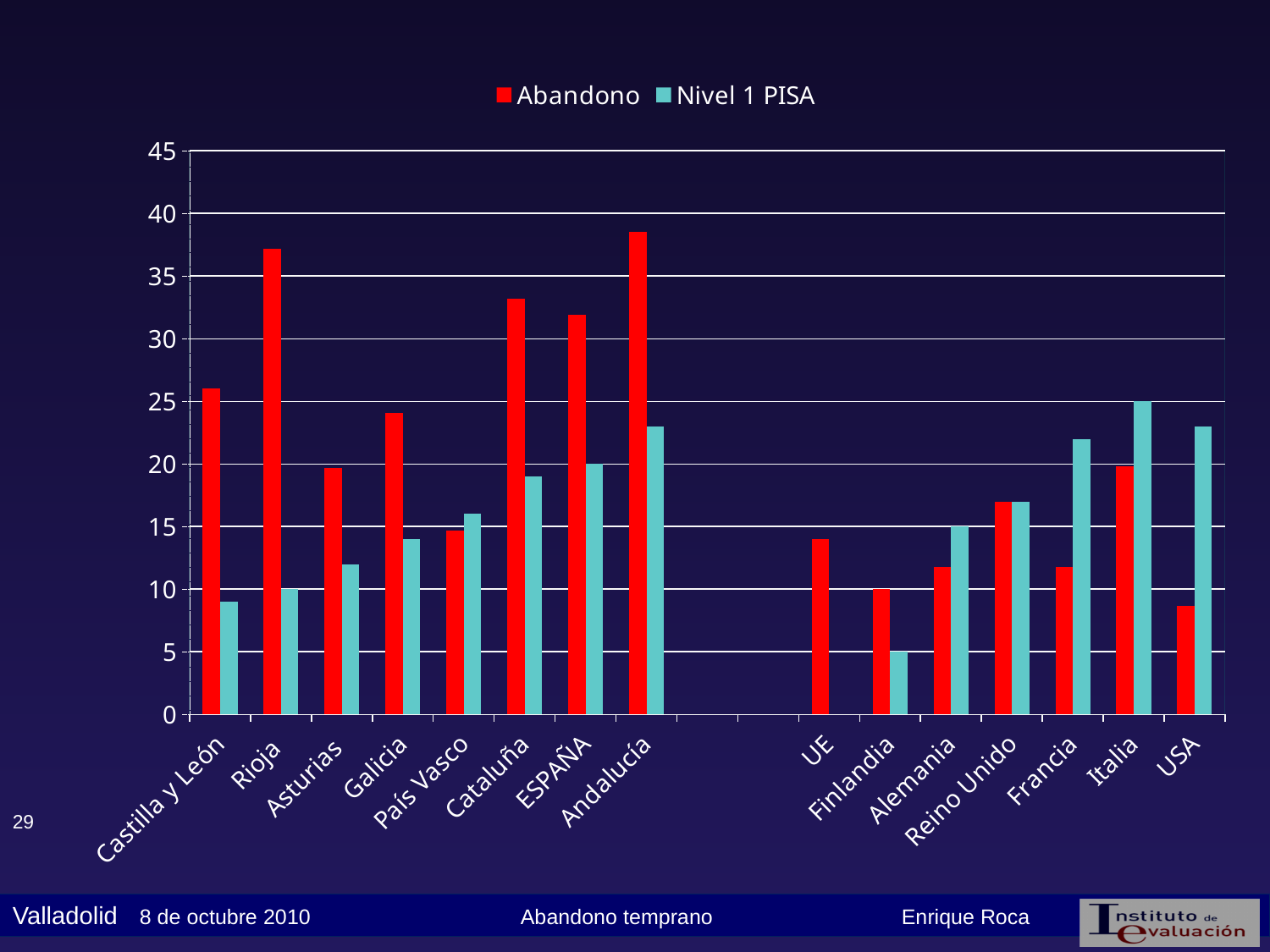
Which category has the highest Nivel 1 PISA value? Italia How many series does the legend list? 2 What type of chart is shown on the slide? bar chart Is the Abandono value for Rioja greater or less than 35? greater For Francia, which is larger: Abandono or Nivel 1 PISA? Nivel 1 PISA Is the Nivel 1 PISA value for USA greater or less than 20? greater How many categories are shown on the x axis? 15 Is the Abandono value for Galicia greater or less than 25? less What are the two series named in the legend? Abandono and Nivel 1 PISA Which category has the lowest Nivel 1 PISA value? Finlandia For Castilla y León, which is larger: Abandono or Nivel 1 PISA? Abandono Which category has the highest Abandono value? Andalucía